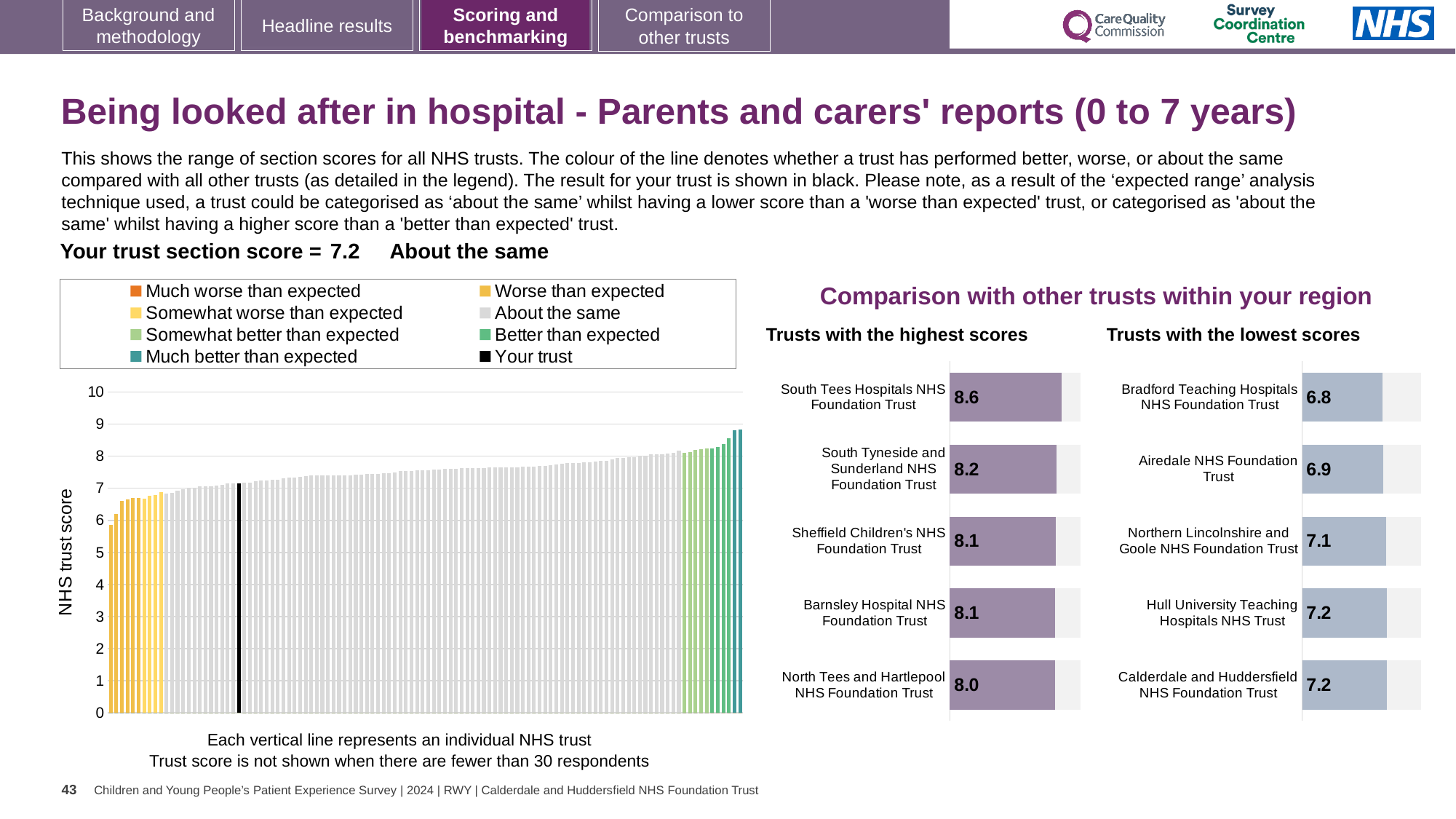
In the 'Trusts with the lowest scores' chart, which has the larger score: Airedale NHS Foundation Trust or Northern Lincolnshire and Goole NHS Foundation Trust? Northern Lincolnshire and Goole NHS Foundation Trust In the NHS trust score chart on the left, is the value of the highest bar greater or less than 8? greater In the 'Trusts with the highest scores' chart, what is the score for North Tees and Hartlepool NHS Foundation Trust? 8.0 In the 'Trusts with the lowest scores' chart, which trust has the lowest score? Bradford Teaching Hospitals NHS Foundation Trust In the 'Trusts with the highest scores' chart, what is the difference between the scores of South Tees Hospitals NHS Foundation Trust and North Tees and Hartlepool NHS Foundation Trust? 0.6 In the 'Trusts with the lowest scores' chart, what is the score for Hull University Teaching Hospitals NHS Trust? 7.2 In the 'Trusts with the highest scores' chart, what is the score for South Tees Hospitals NHS Foundation Trust? 8.6 How many entries does the legend of the NHS trust score chart on the left list? 8 In the 'Trusts with the highest scores' chart, which trust has the highest score? South Tees Hospitals NHS Foundation Trust How many trusts are shown in the 'Trusts with the highest scores' chart? 5 In the 'Trusts with the lowest scores' chart, what is the score for Bradford Teaching Hospitals NHS Foundation Trust? 6.8 In the NHS trust score chart on the left, do the bar values rise or fall from left to right? rise